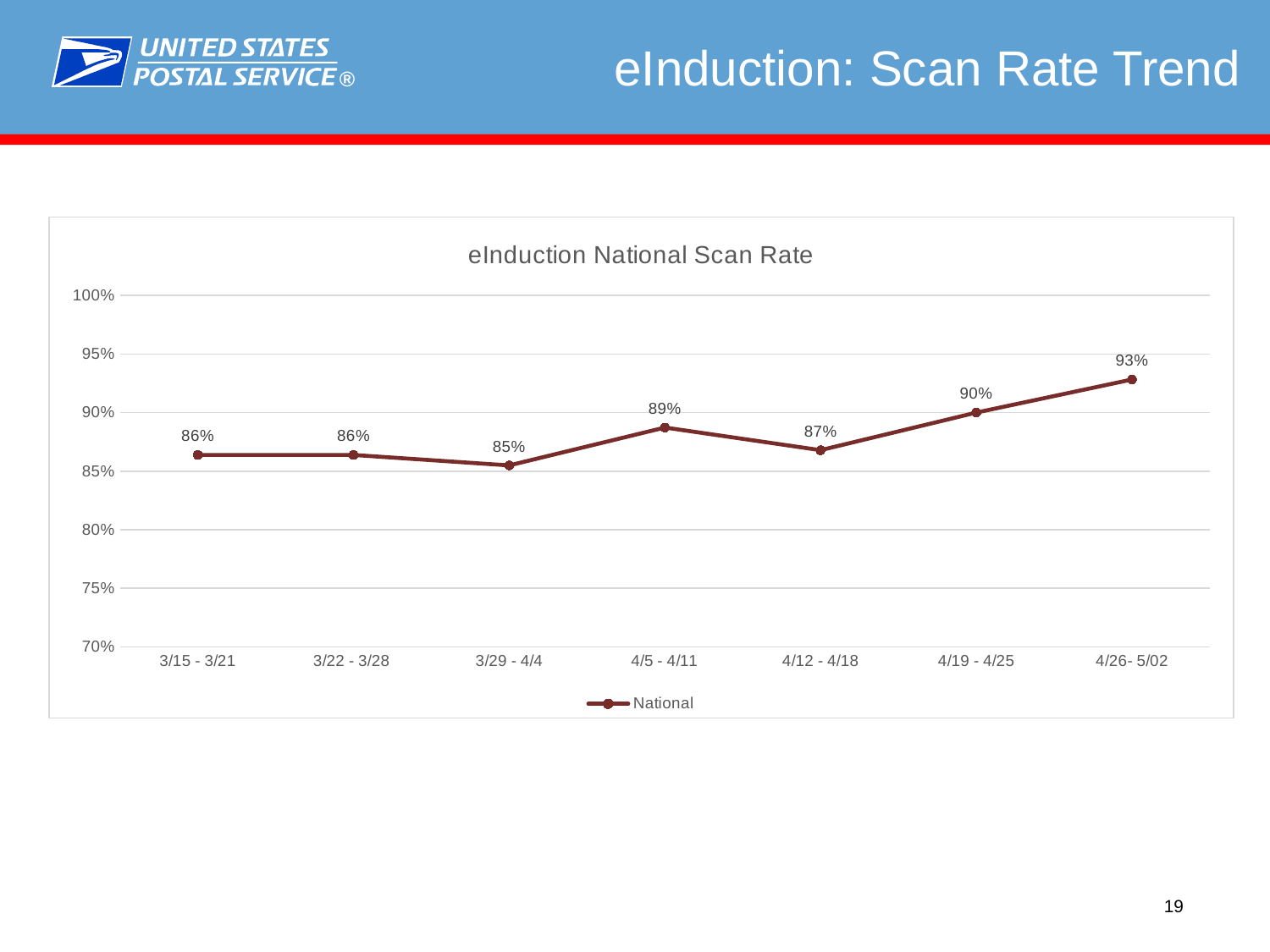
What kind of chart is shown on the slide? line chart What is the title of the chart? eInduction National Scan Rate Which week has a higher scan rate, 4/5 - 4/11 or 4/12 - 4/18? 4/5 - 4/11 Which week has the highest National scan rate? 4/26- 5/02 How many weeks are plotted on the chart? 7 Is the scan rate for 4/19 - 4/25 greater or less than 85%? greater How many series does the legend list? 1 What is the difference between the scan rate for 4/26- 5/02 and the scan rate for 3/15 - 3/21? 7% What is the National scan rate for the week 4/26- 5/02? 93% What is the National scan rate for the week 4/12 - 4/18? 87% What is the National scan rate for the week 3/29 - 4/4? 85% Which week has the lowest National scan rate? 3/29 - 4/4